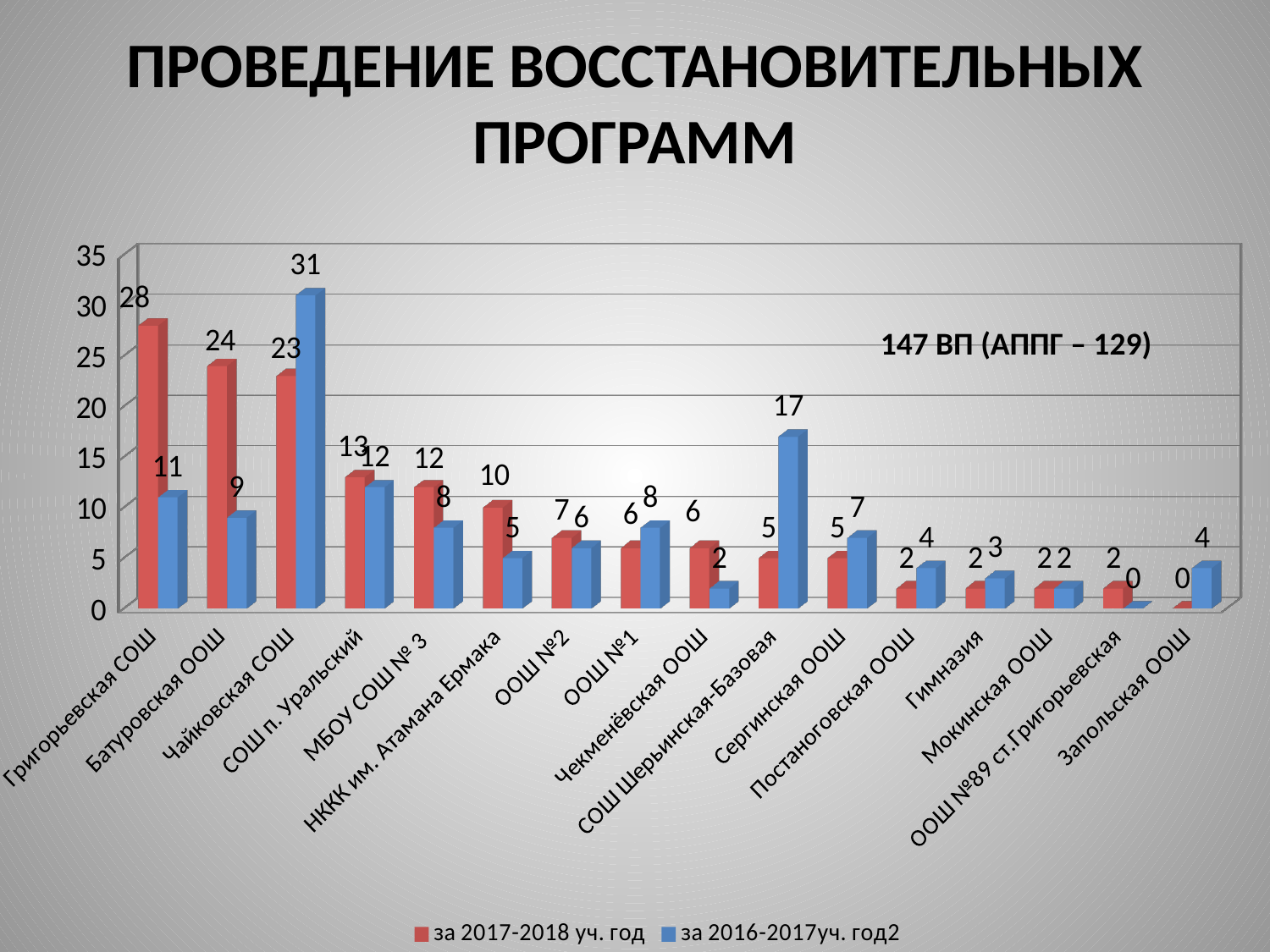
What is the value for Запольская ООШ in the series 'за 2017-2018 уч. год'? 0 For Батуровская ООШ, which series has the larger value: 'за 2017-2018 уч. год' or 'за 2016-2017уч. год2'? за 2017-2018 уч. год What is the value for СОШ Шерьинская-Базовая in the series 'за 2016-2017уч. год2'? 17 What is the value for Чайковская СОШ in the series 'за 2016-2017уч. год2'? 31 How many categories are shown on the x axis? 16 What is the difference between the two series for Чайковская СОШ? 8 How many series does the legend list? 2 Which category has the highest value in the series 'за 2017-2018 уч. год'? Григорьевская СОШ What is the value for Григорьевская СОШ in the series 'за 2017-2018 уч. год'? 28 What kind of chart is shown on the slide? Bar chart Which category has the highest value in the series 'за 2016-2017уч. год2'? Чайковская СОШ What text annotation is shown inside the chart area? 147 ВП (АППГ – 129)